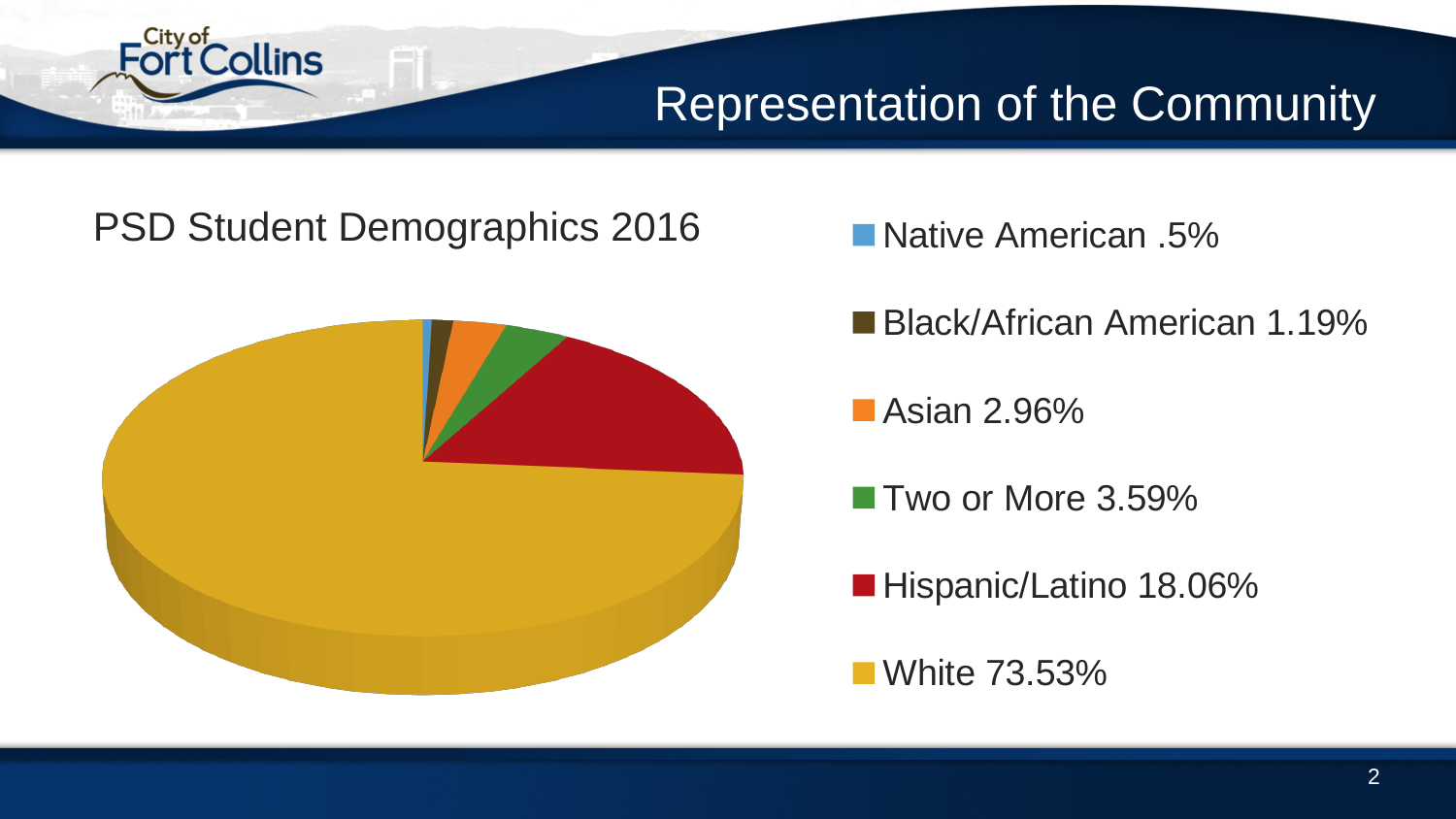
Which category has the smallest slice of the pie? Native American What kind of chart is shown on the slide? Pie chart What is the title of the chart? PSD Student Demographics 2016 What share of the pie is Two or More? 3.59% What share of the pie is White? 73.53% Which category has the largest slice of the pie? White What share of the pie is Asian? 2.96% How many categories does the pie chart show? 6 What colour is the Hispanic/Latino slice? Red Which is larger, the share for Two or More or the share for Asian? Two or More